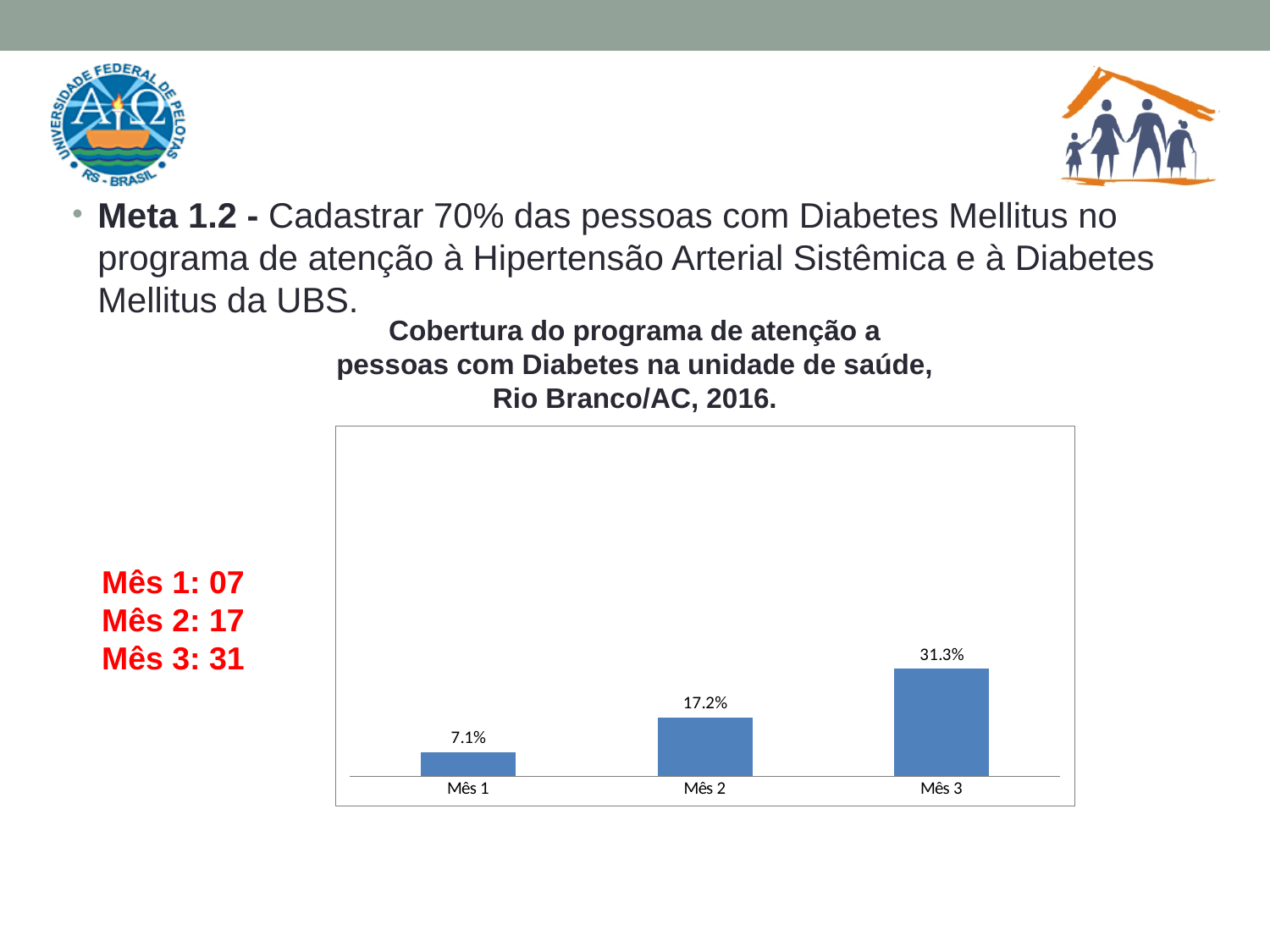
What is the value for Mês 3? 31.3% What is the difference between the values for Mês 3 and Mês 2? 14.1% What is the value for Mês 2? 17.2% Which is larger, the value for Mês 2 or the value for Mês 3? Mês 3 Do the values rise or fall from Mês 1 to Mês 3? Rise How many months are shown on the x axis of the chart? 3 What is the difference between the values for Mês 2 and Mês 1? 10.1% What is the value for Mês 1? 7.1% Which month has the highest coverage value? Mês 3 Which month has the lowest coverage value? Mês 1 What is the title of the chart? Cobertura do programa de atenção a pessoas com Diabetes na unidade de saúde, Rio Branco/AC, 2016. What kind of chart is shown on the slide? Bar chart